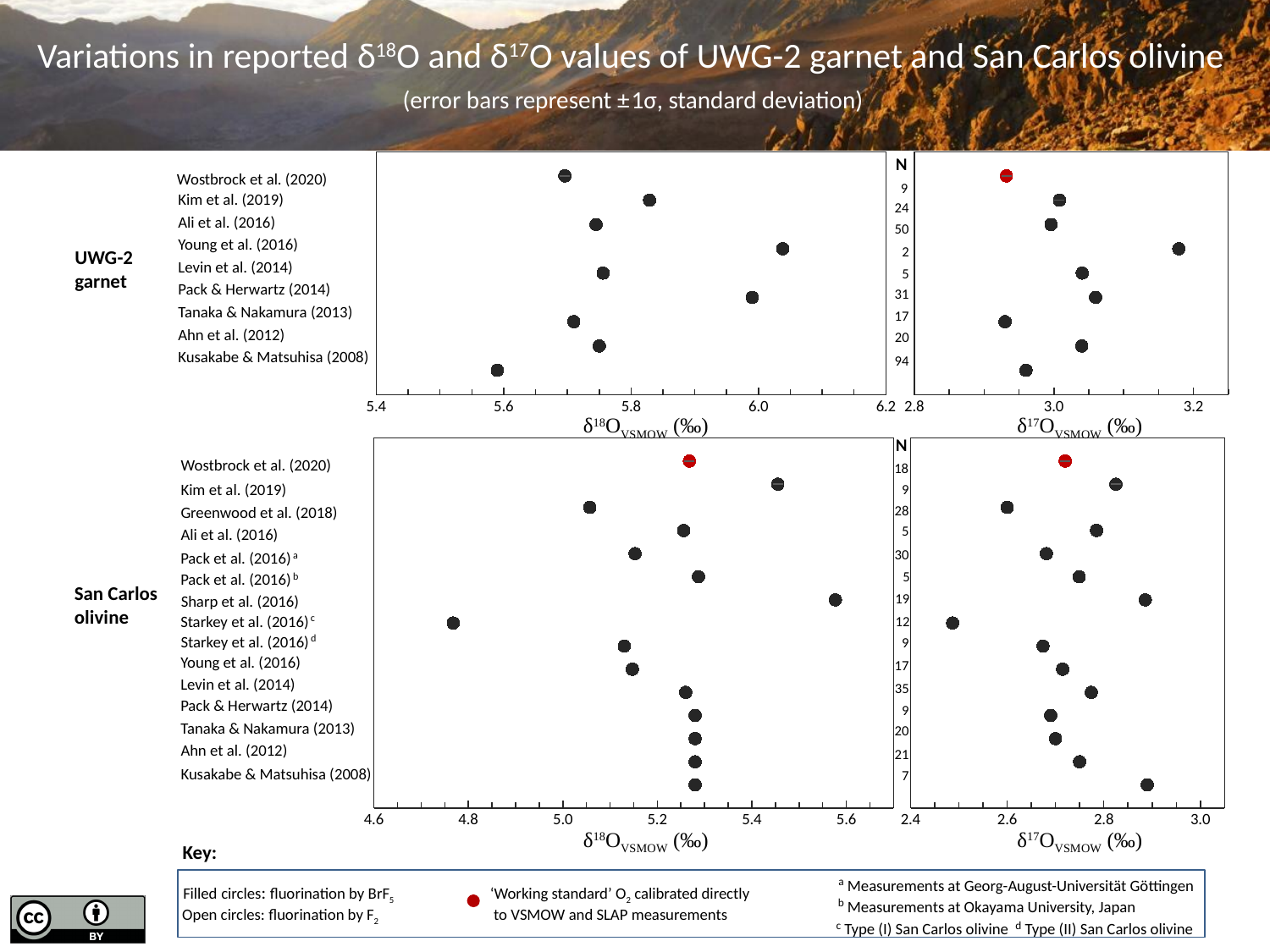
In the UWG-2 garnet δ17O chart, which study reports the highest δ17O value? Young et al. (2016) In the San Carlos olivine δ18O chart, which study reports the lowest δ18O value? Starkey et al. (2016) c How many studies are plotted in the San Carlos olivine charts? 15 In the San Carlos olivine δ18O chart, which has the larger δ18O value: Kim et al. (2019) or Wostbrock et al. (2020)? Kim et al. (2019) In the UWG-2 garnet δ18O chart, which study reports the lowest δ18O value? Kusakabe & Matsuhisa (2008) How many studies are plotted in the UWG-2 garnet charts? 9 In the San Carlos olivine δ18O chart, which study reports the highest δ18O value? Sharp et al. (2016) In the San Carlos olivine δ17O chart, is the value for Starkey et al. (2016) c greater or less than 2.6? less In the UWG-2 garnet δ18O chart, which study reports the highest δ18O value? Young et al. (2016) What kind of chart is used for the UWG-2 garnet δ18O panel? scatter (dot) plot In the UWG-2 garnet δ18O chart, is the value for Young et al. (2016) greater or less than 6.0? greater